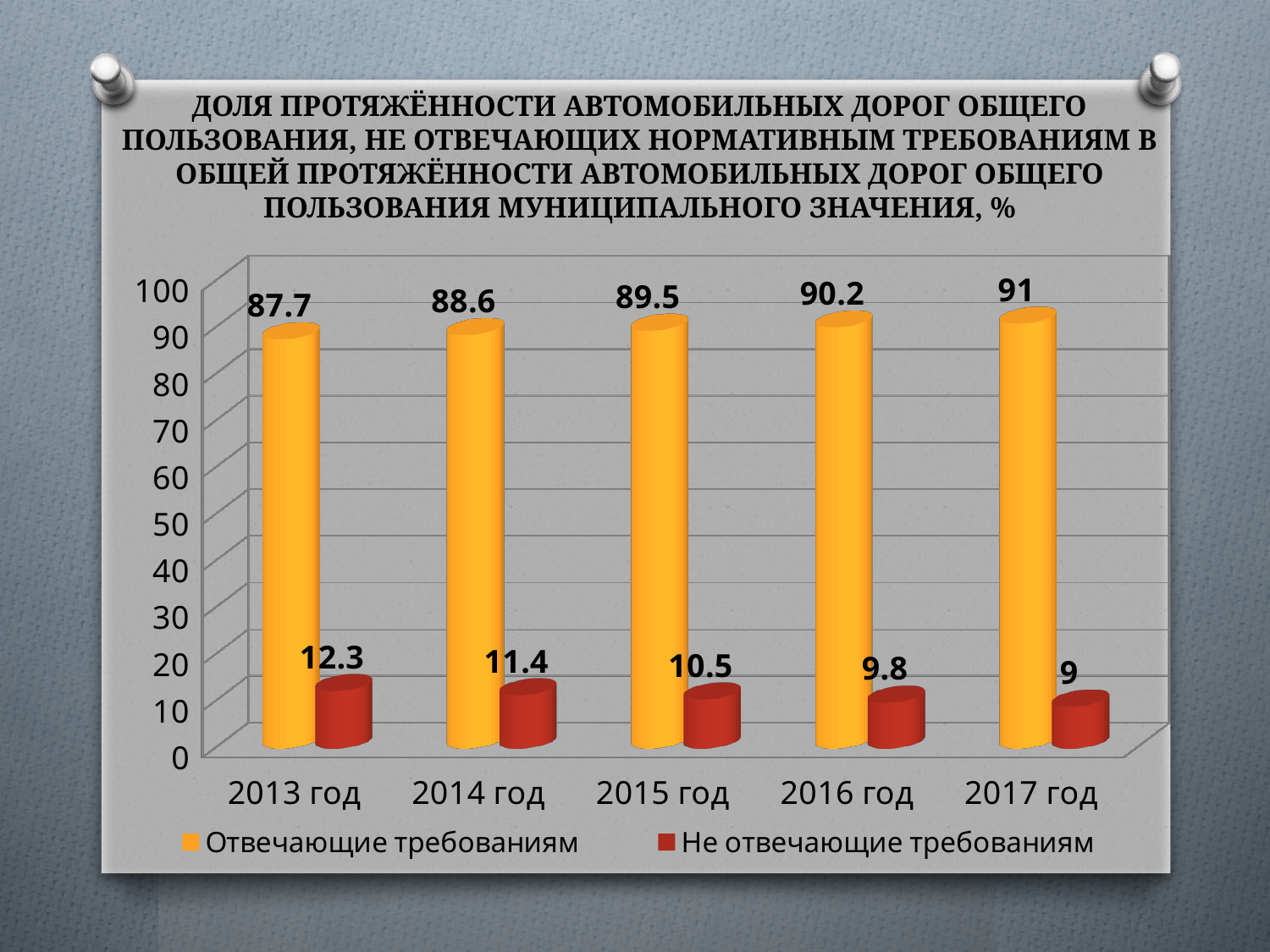
Which year has the lowest value for "Отвечающие требованиям"? 2013 год How many series does the legend list? 2 What is the value for "Не отвечающие требованиям" in 2015 год? 10.5 How many years are shown on the x axis? 5 What is the value for "Отвечающие требованиям" in 2013 год? 87.7 Do the values for "Не отвечающие требованиям" rise or fall from 2013 год to 2017 год? fall What kind of chart is shown on the slide? bar chart Is the value for "Не отвечающие требованиям" in 2016 год greater or less than 20? less Which year has the highest value for "Не отвечающие требованиям"? 2013 год Which is larger: the "Отвечающие требованиям" value for 2014 год or for 2016 год? 2016 год What is the difference between the "Не отвечающие требованиям" values for 2013 год and 2017 год? 3.3 What is the value for "Отвечающие требованиям" in 2017 год? 91